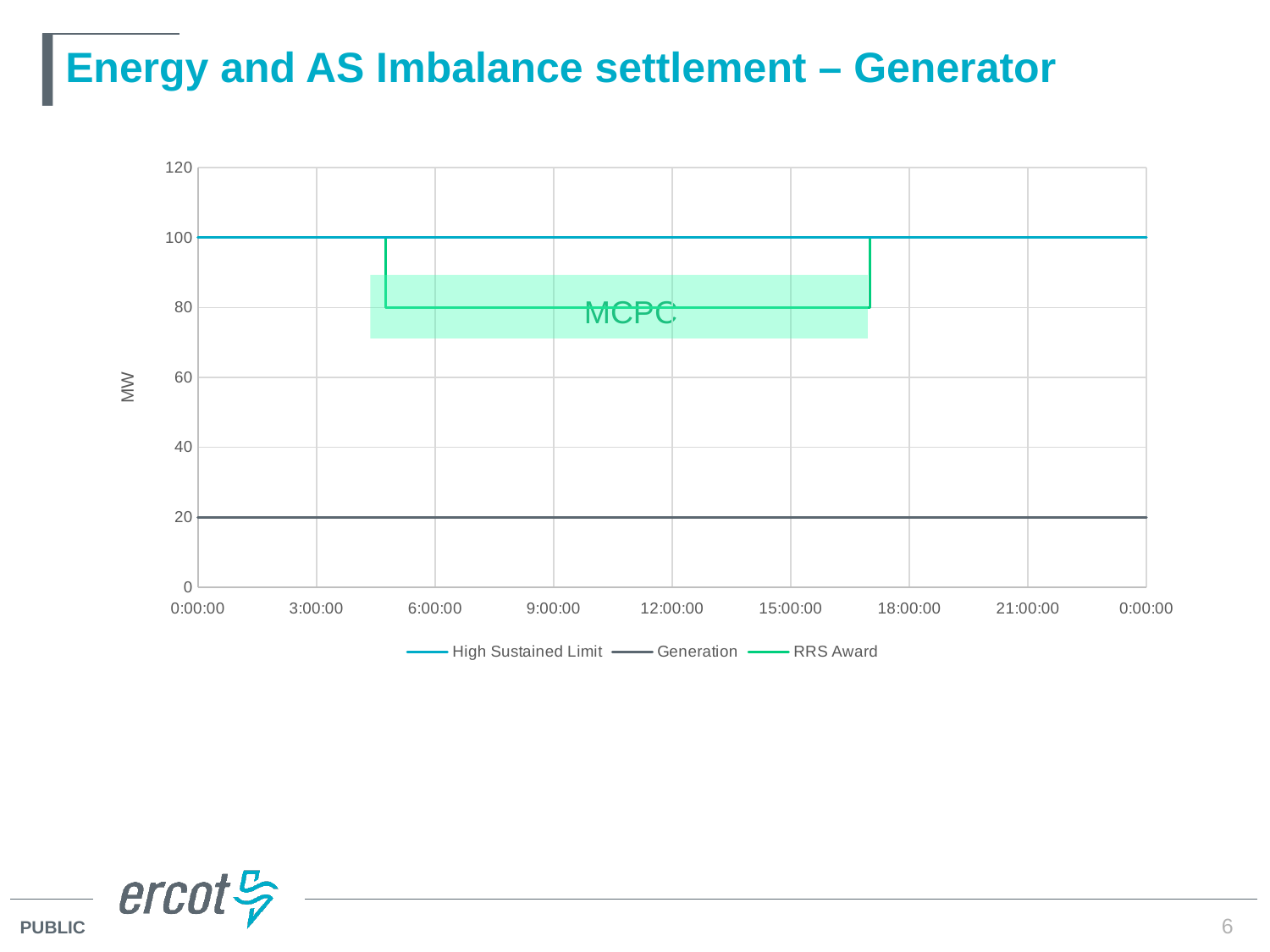
What is the difference between the High Sustained Limit and the RRS Award at 12:00:00? 20 What is the value of the Generation line at 9:00:00? 20 What is the value of the High Sustained Limit line at 12:00:00? 100 How many series does the legend list? 3 What text label appears inside the shaded green area on the chart? MCPC What kind of chart is shown on the slide? line chart Which series has the highest value at 12:00:00? High Sustained Limit Which series has the lowest value at 12:00:00? Generation Is the Generation value at 15:00:00 greater or less than 40? less What is the value of the RRS Award line at 12:00:00? 80 What label is shown on the y axis? MW